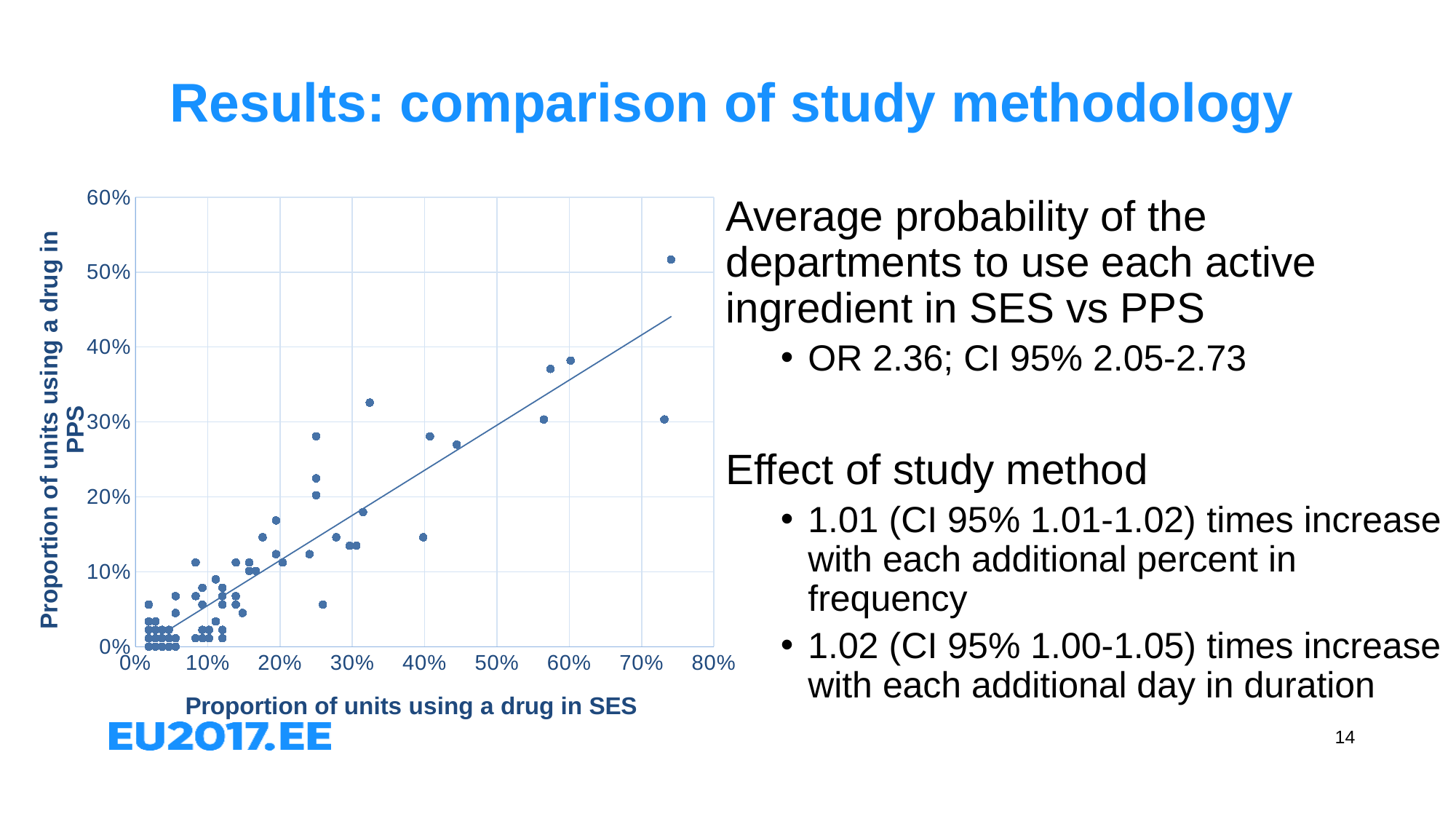
Is the PPS value of the point at roughly 60% SES greater or less than 30%? greater Is the PPS value of the highest point on the chart greater or less than 40%? greater What is the title of the x axis of the chart? Proportion of units using a drug in SES What kind of chart is shown on the slide? Scatter chart What is the title of the y axis of the chart? Proportion of units using a drug in PPS Do the plotted values generally rise or fall as the proportion in SES increases along the x axis? Rise Is the PPS value of the point with the largest SES proportion greater or less than 40%? greater